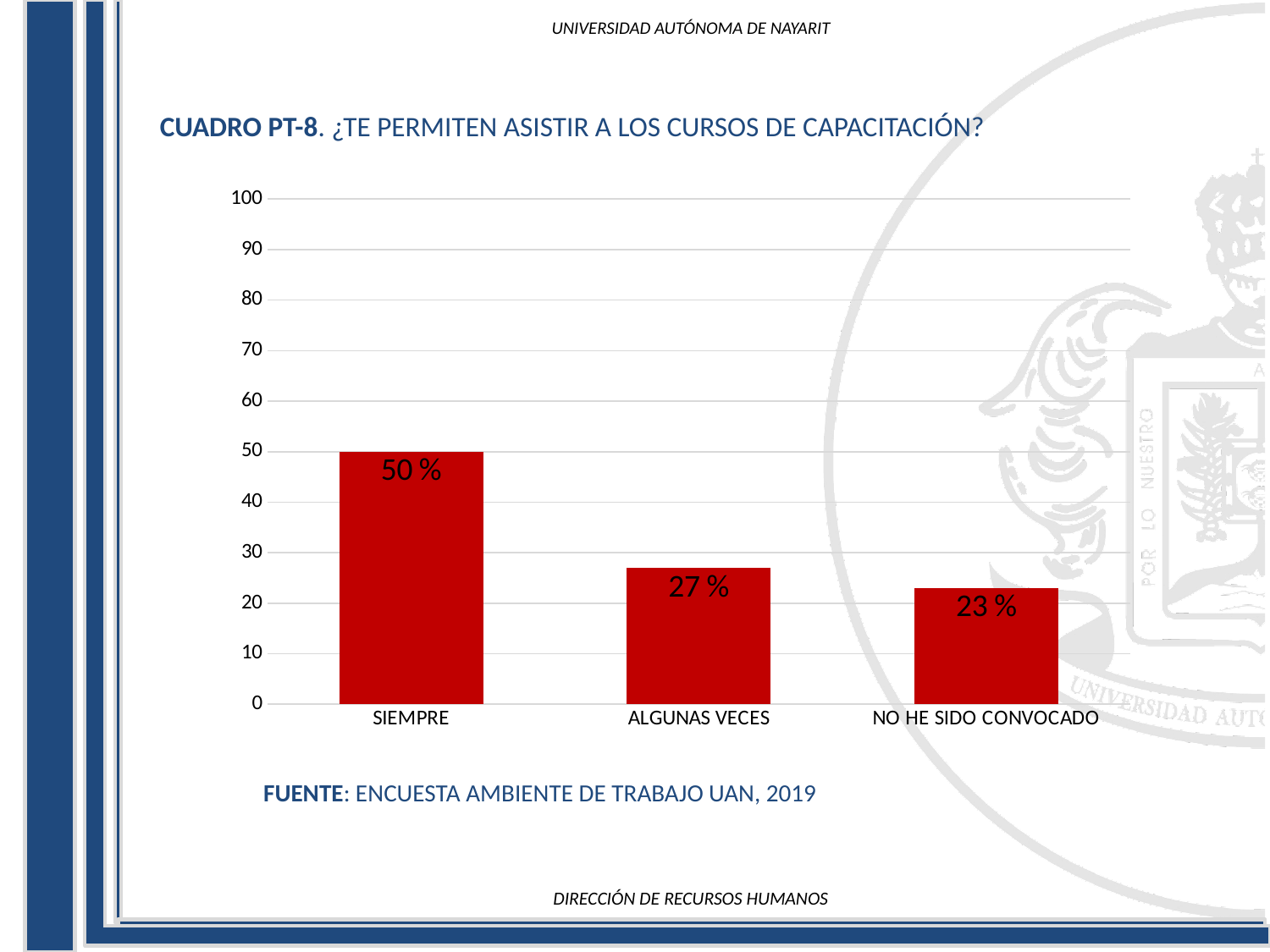
What is the value for NO HE SIDO CONVOCADO? 23 % How many categories are shown on the x axis? 3 Which category has the highest value? SIEMPRE Do the values rise or fall from left to right along the x axis? fall What kind of chart is shown on the slide? bar chart What is the difference between the values for SIEMPRE and ALGUNAS VECES? 23 % Which is larger, the value for SIEMPRE or the value for NO HE SIDO CONVOCADO? SIEMPRE Which category has the lowest value? NO HE SIDO CONVOCADO Is the value for ALGUNAS VECES greater or less than 30? less What is the value for SIEMPRE? 50 % What is the value for ALGUNAS VECES? 27 % What is the difference between the values for ALGUNAS VECES and NO HE SIDO CONVOCADO? 4 %